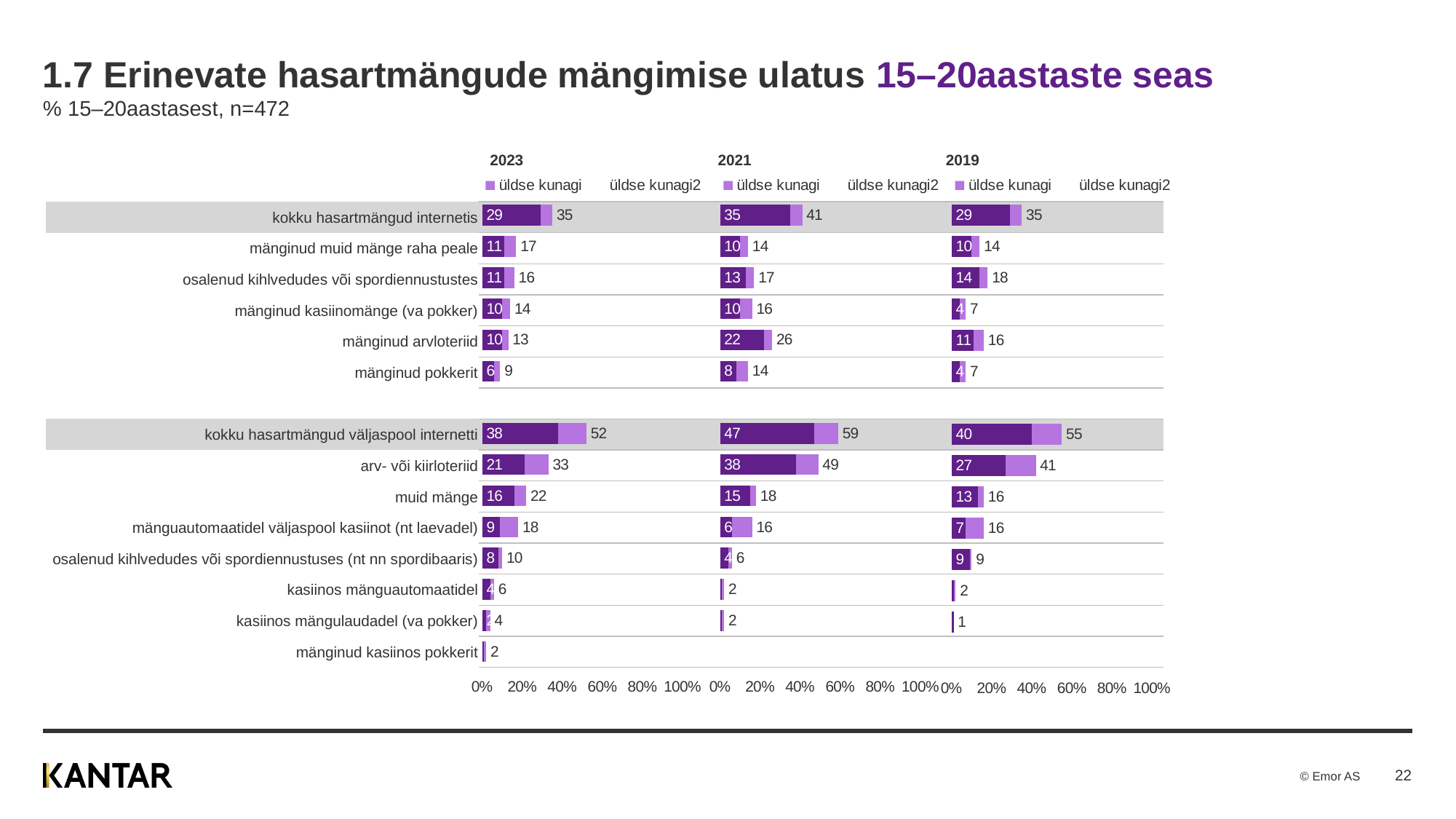
What kind of chart is the 2023 chart? bar chart What is the difference between the 'üldse kunagi' (dark purple) value for 'kokku hasartmängud internetis' in the 2021 chart and in the 2019 chart? 6 In the 2021 chart, what is the outer label at the end of the bar for 'kokku hasartmängud väljaspool internetti'? 59 In the 2021 chart, what is the 'üldse kunagi' (dark purple) value for 'mänginud arvloteriid'? 22 In the 2023 chart, which has the larger 'üldse kunagi' (dark purple) value: 'muid mänge' or 'mänginud arvloteriid'? muid mänge In the 2019 chart, what is the 'üldse kunagi' (dark purple) value for 'mänginud kasiinomänge (va pokker)'? 4 In the 2019 chart, what is the 'üldse kunagi' (dark purple) value for 'arv- või kiirloteriid'? 27 In the 2023 chart, which category has the highest 'üldse kunagi' (dark purple) value? kokku hasartmängud väljaspool internetti In the 2023 chart, what is the 'üldse kunagi' (dark purple) value for 'kokku hasartmängud internetis'? 29 In the 2021 chart, is the full bar for 'kokku hasartmängud väljaspool internetti' greater or less than 40%? greater How many series does the legend of the 2023 chart list? 2 How many categories are shown in the 2023 chart? 14